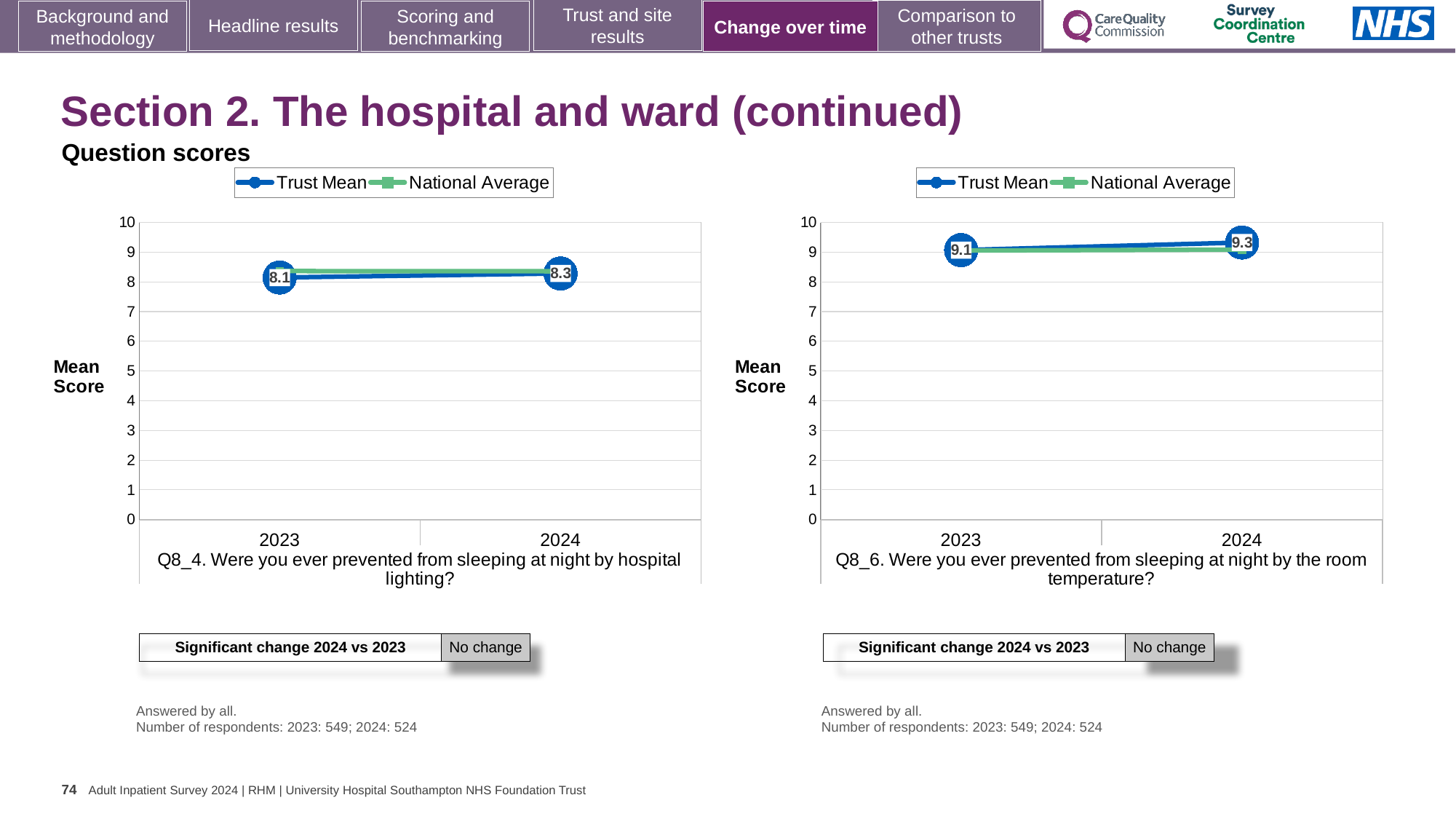
In the right chart (Q8_6, room temperature), what is the Trust Mean for 2024? 9.3 In the left chart (Q8_4, hospital lighting), what is the Trust Mean for 2023? 8.1 In the right chart (Q8_6, room temperature), does the Trust Mean rise or fall from 2023 to 2024? rise In the left chart (Q8_4, hospital lighting), which year has the higher Trust Mean, 2023 or 2024? 2024 What kind of chart is used for the Q8_4 hospital lighting question? line chart In the right chart (Q8_6, room temperature), what is the difference between the Trust Mean in 2024 and in 2023? 0.2 How many series does the legend of the right chart (Q8_6, room temperature) list? 2 In the left chart (Q8_4, hospital lighting), what is the Trust Mean for 2024? 8.3 How many years are plotted on the x axis of the left chart (Q8_4, hospital lighting)? 2 In the right chart (Q8_6, room temperature), is the National Average for 2024 greater or less than 8? greater In the left chart (Q8_4, hospital lighting), by how much did the Trust Mean change from 2023 to 2024? 0.2 In the right chart (Q8_6, room temperature), what is the Trust Mean for 2023? 9.1